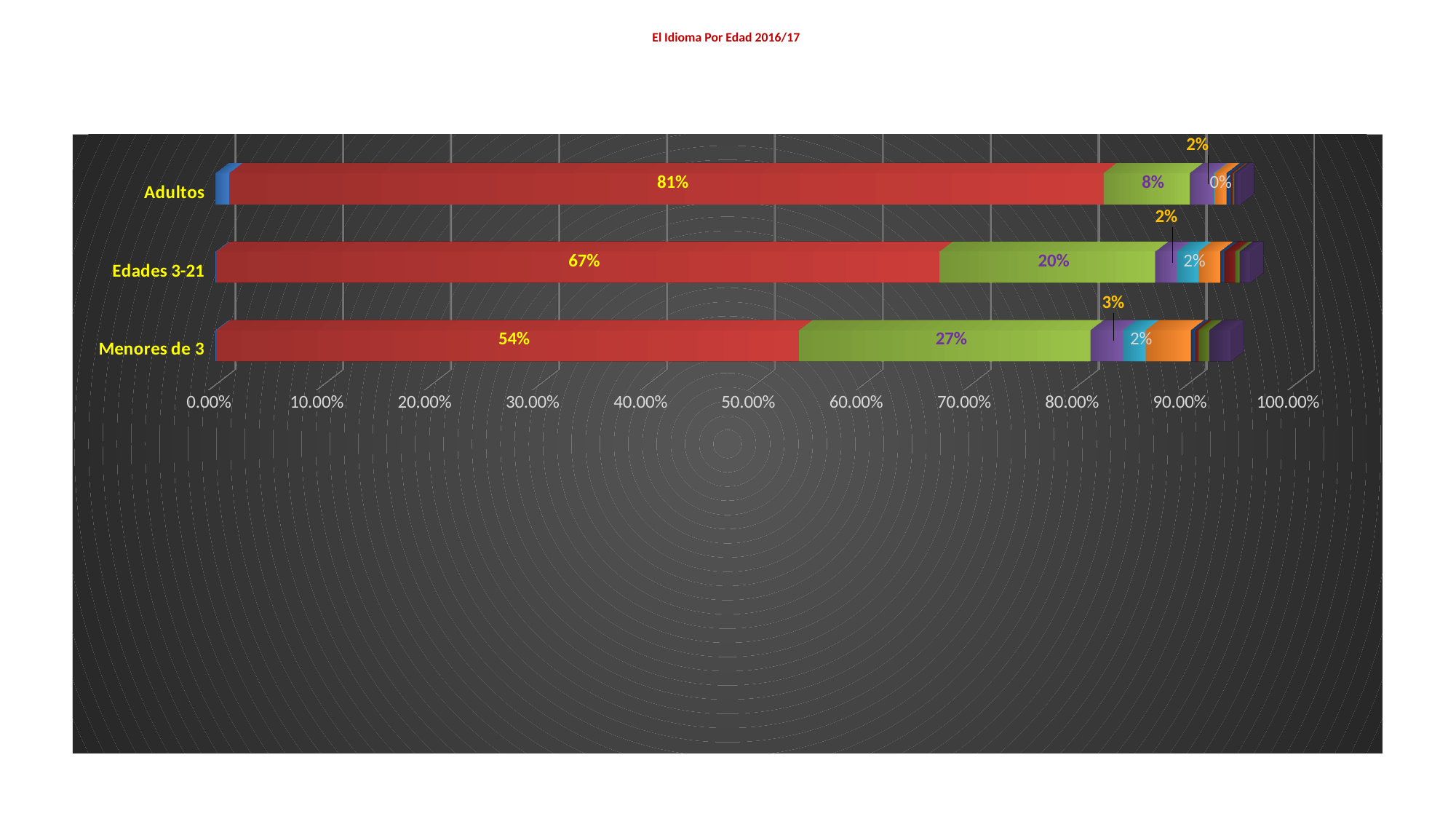
What is the value of the green segment for Menores de 3? 27% How many categories (age groups) are shown on the chart? 3 What is the value of the red segment for Menores de 3? 54% Is the green segment larger for Edades 3-21 or for Menores de 3? Menores de 3 What is the value of the red segment for Adultos? 81% What is the difference between the red segment for Adultos and the red segment for Menores de 3? 27% What kind of chart is shown on the slide? stacked bar chart What is the value of the red segment for Edades 3-21? 67% What is the value of the green segment for Adultos? 8% Which category has the largest red segment? Adultos What is the title of the chart? El Idioma Por Edad 2016/17 Which category has the smallest green segment? Adultos